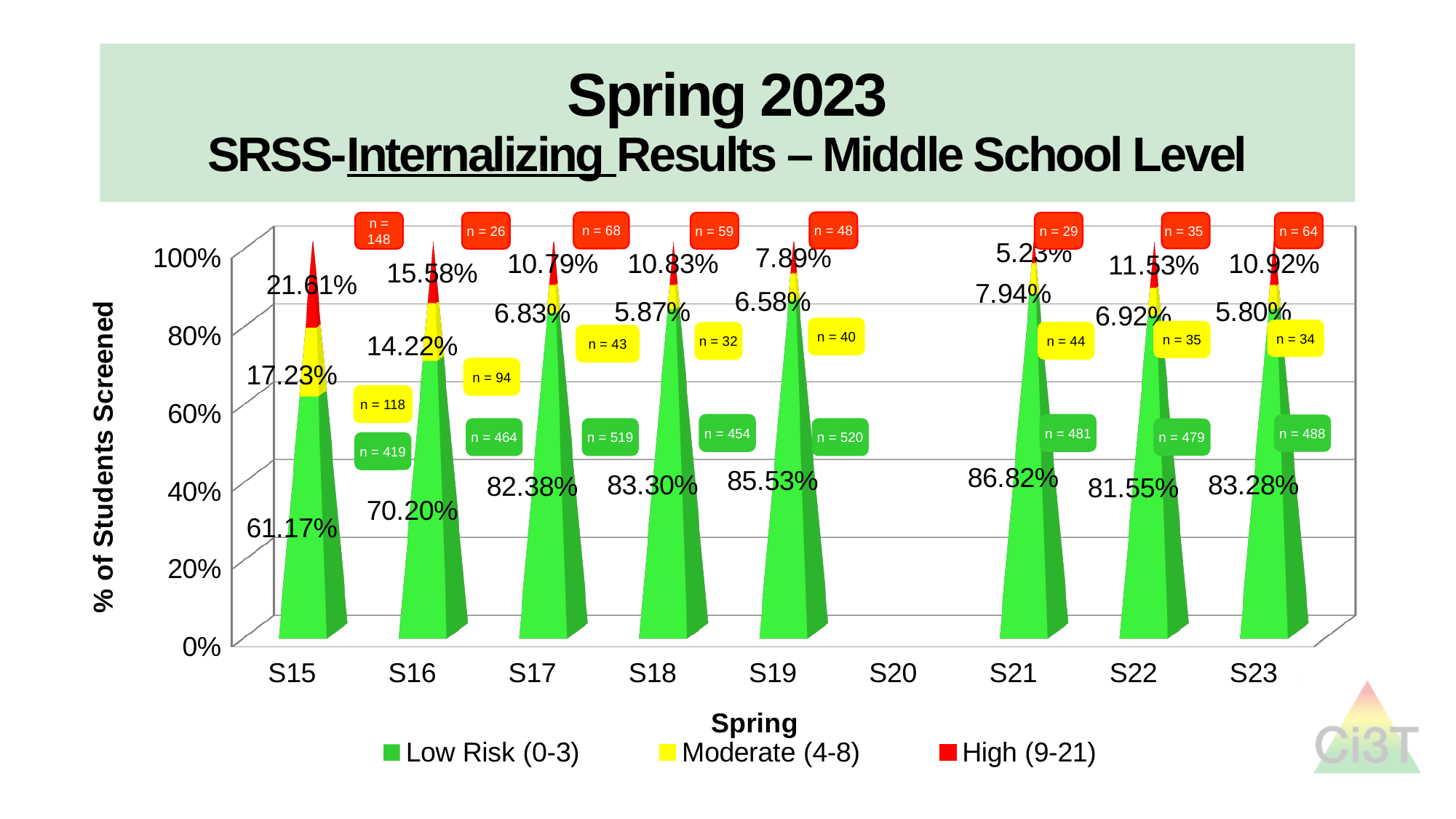
What was the Moderate (4-8) percentage in S23? 5.80% How many spring labels appear on the x axis? 9 Which spring had the highest Low Risk (0-3) percentage? S21 How many students (n) were in the Moderate (4-8) group in S17? 94 Did the Low Risk (0-3) percentage rise or fall from S15 to S19? Rise Which spring had the lowest High (9-21) percentage? S21 Which spring had the larger Moderate (4-8) percentage, S15 or S16? S15 What kind of chart is shown on the slide? Stacked bar chart What percentage of students were High (9-21) in S22? 11.53% How much higher was the Low Risk (0-3) percentage in S19 than in S15? 24.36 percentage points What percentage of students were Low Risk (0-3) in S15? 61.17% How many series does the legend list? 3